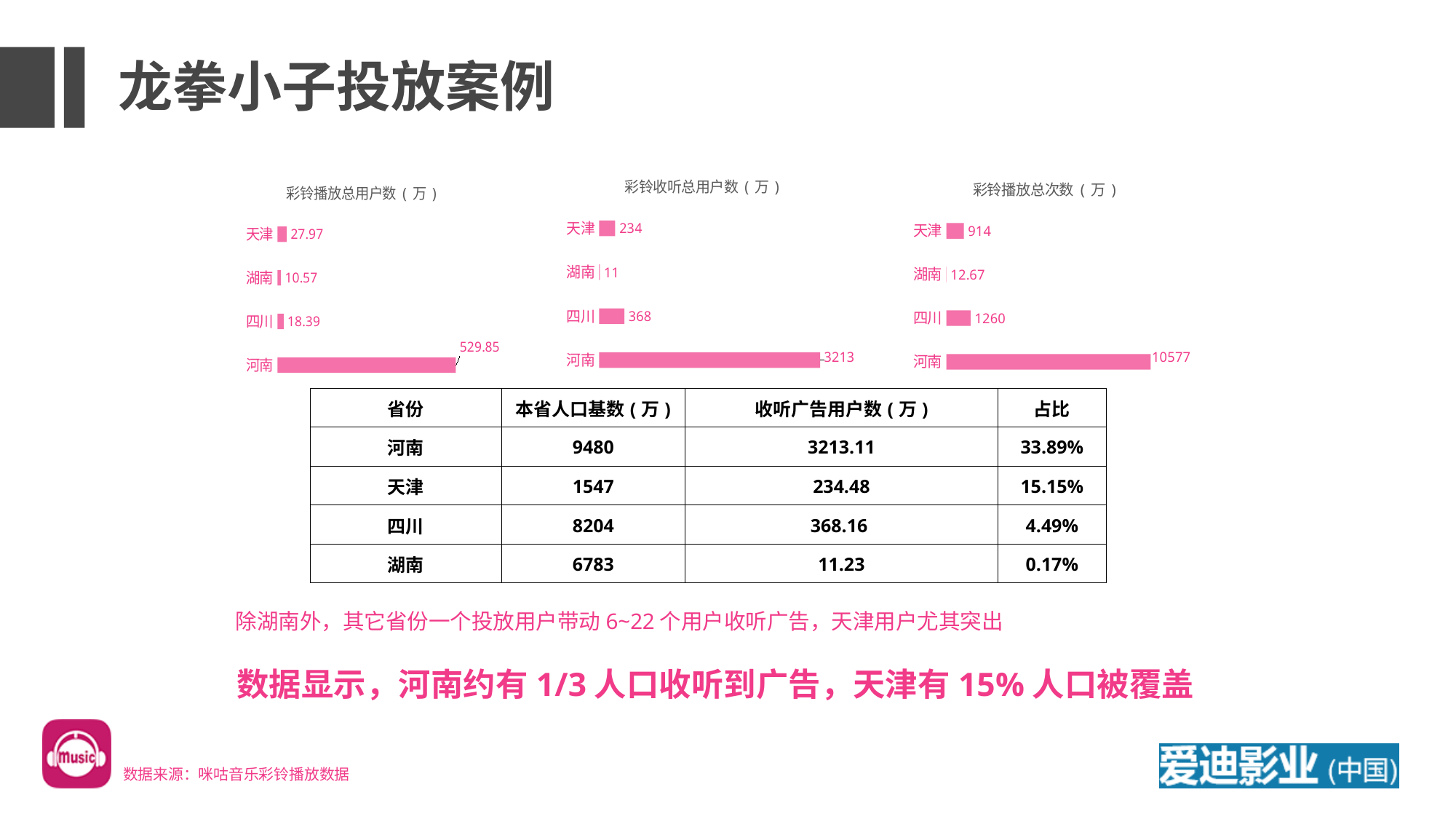
In the chart titled 彩铃播放总次数（万）, which is larger, the value for 四川 or the value for 天津? 四川 In the chart titled 彩铃播放总次数（万）, what is the value for 湖南? 12.67 In the chart titled 彩铃收听总用户数（万）, what is the value for 四川? 368 What type of chart is the chart titled 彩铃收听总用户数（万）? bar chart In the chart titled 彩铃播放总用户数（万）, which category has the lowest value? 湖南 How many categories are shown in the chart titled 彩铃播放总次数（万）? 4 In the chart titled 彩铃播放总用户数（万）, what is the value for 河南? 529.85 In the chart titled 彩铃播放总次数（万）, what is the difference between the values for 河南 and 四川? 9317 In the chart titled 彩铃收听总用户数（万）, which category has the highest value? 河南 In the chart titled 彩铃收听总用户数（万）, what is the difference between the values for 四川 and 天津? 134 In the chart titled 彩铃播放总用户数（万）, what is the value for 天津? 27.97 How many charts are shown on the slide? 3